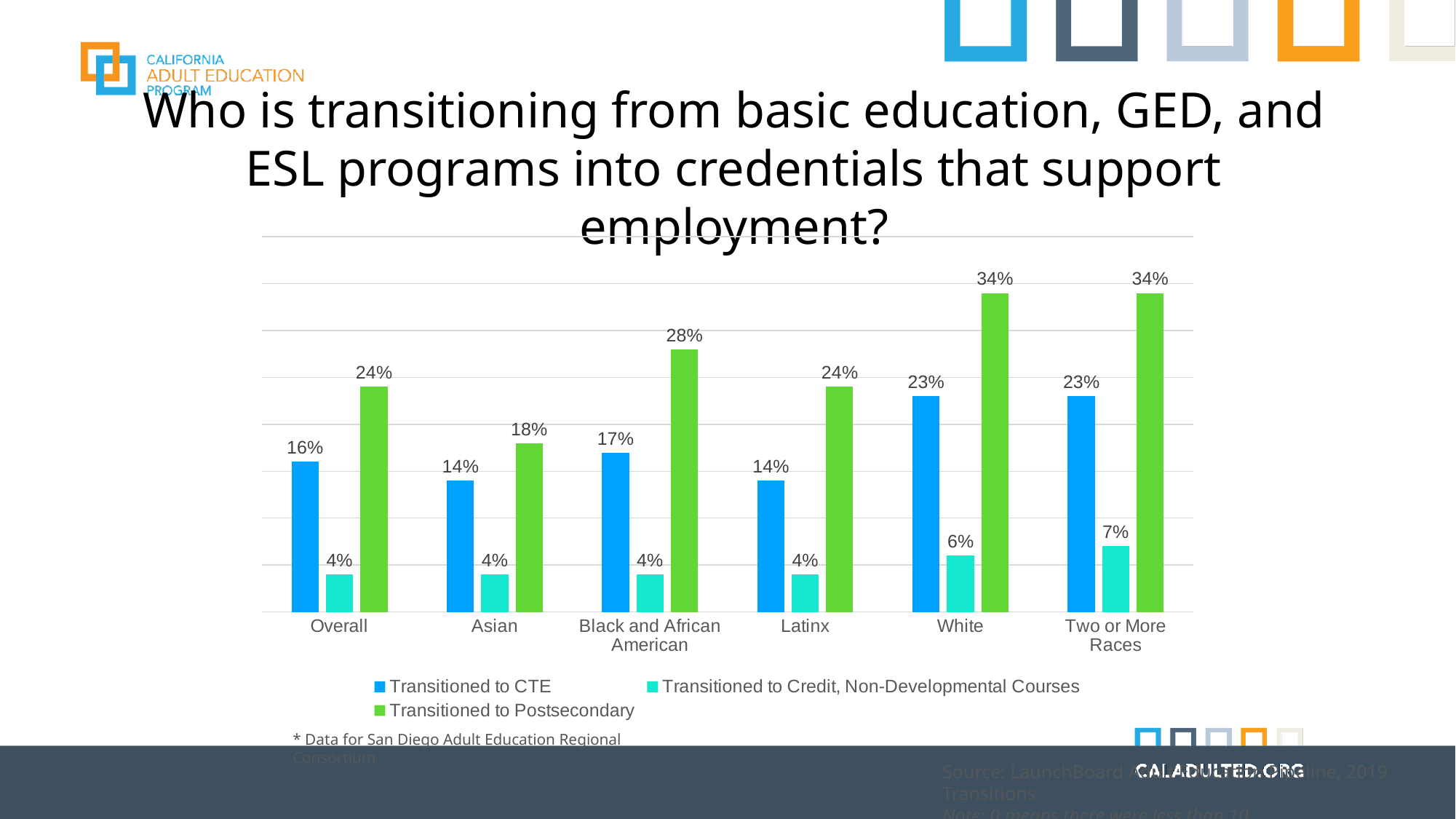
How many series does the legend list? 3 What is the value for Transitioned to Postsecondary for Black and African American? 28% What is the value for Transitioned to Credit, Non-Developmental Courses for White? 6% How many categories are shown on the x axis? 6 What is the value for Transitioned to CTE for Overall? 16% What is the difference between the Transitioned to Postsecondary values for White and Overall? 10% Which category has the lowest value for Transitioned to Postsecondary? Asian Which category has the highest value for Transitioned to Credit, Non-Developmental Courses? Two or More Races Which series is shown in green in the legend? Transitioned to Postsecondary Which is larger: Transitioned to CTE for Black and African American or Transitioned to CTE for Latinx? Black and African American What is the value for Transitioned to Postsecondary for Asian? 18% What kind of chart is shown on the slide? Bar chart